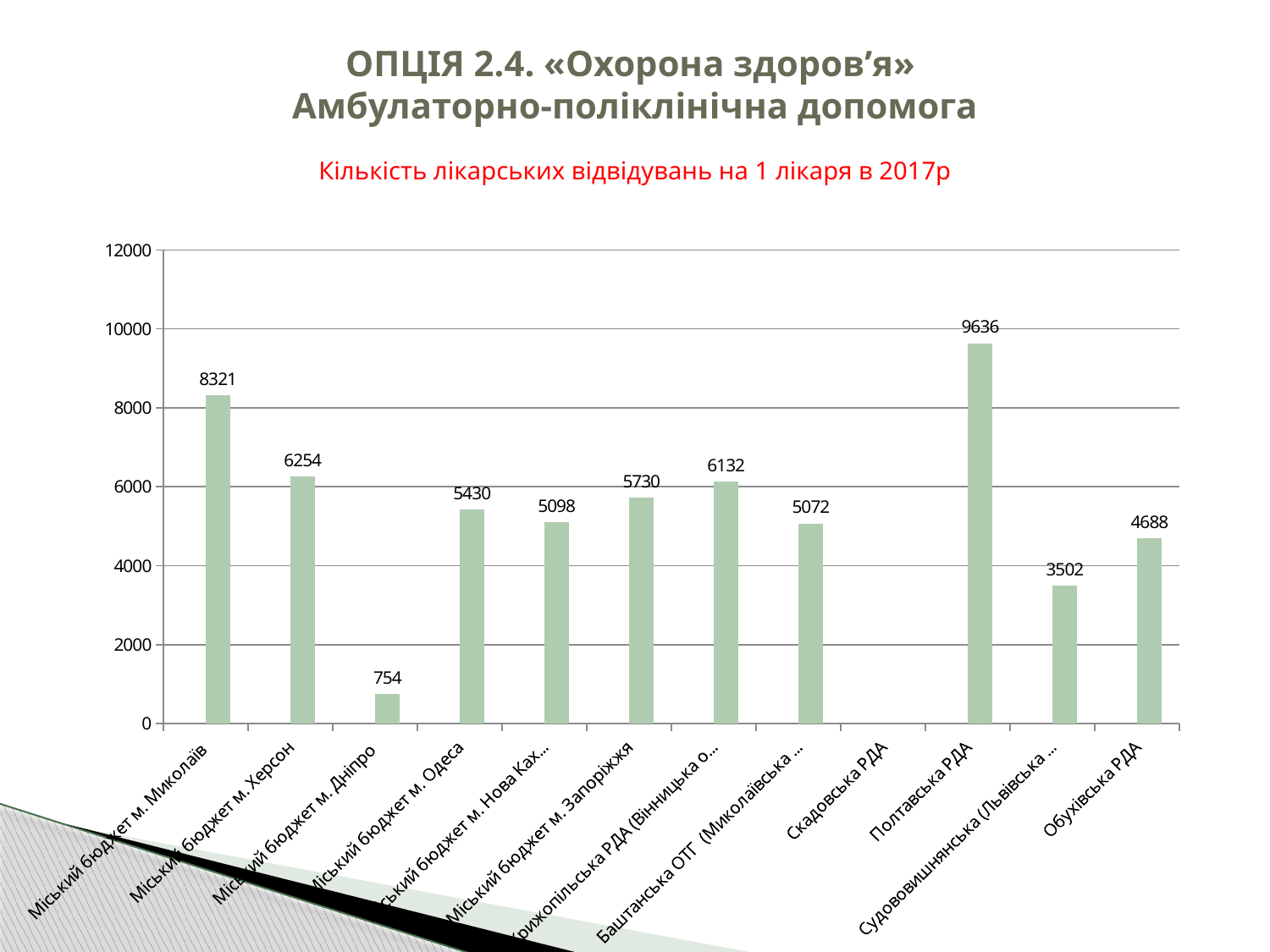
What is the difference between the values for Міський бюджет м. Миколаїв and Міський бюджет м. Херсон? 2067 Which category has the highest value? Полтавська РДА Which plotted category has the lowest value? Міський бюджет м. Дніпро What is the red subtitle above the chart? Кількість лікарських відвідувань на 1 лікаря в 2017р What is the value for Міський бюджет м. Миколаїв? 8321 Which is larger, the value for Міський бюджет м. Одеса or Міський бюджет м. Запоріжжя? Міський бюджет м. Запоріжжя What is the value for Полтавська РДА? 9636 What is the value for Обухівська РДА? 4688 What is the value for Міський бюджет м. Дніпро? 754 What is the difference between the values for Полтавська РДА and Міський бюджет м. Дніпро? 8882 What type of chart is shown on the slide? Bar chart How many bars are plotted on the chart? 11